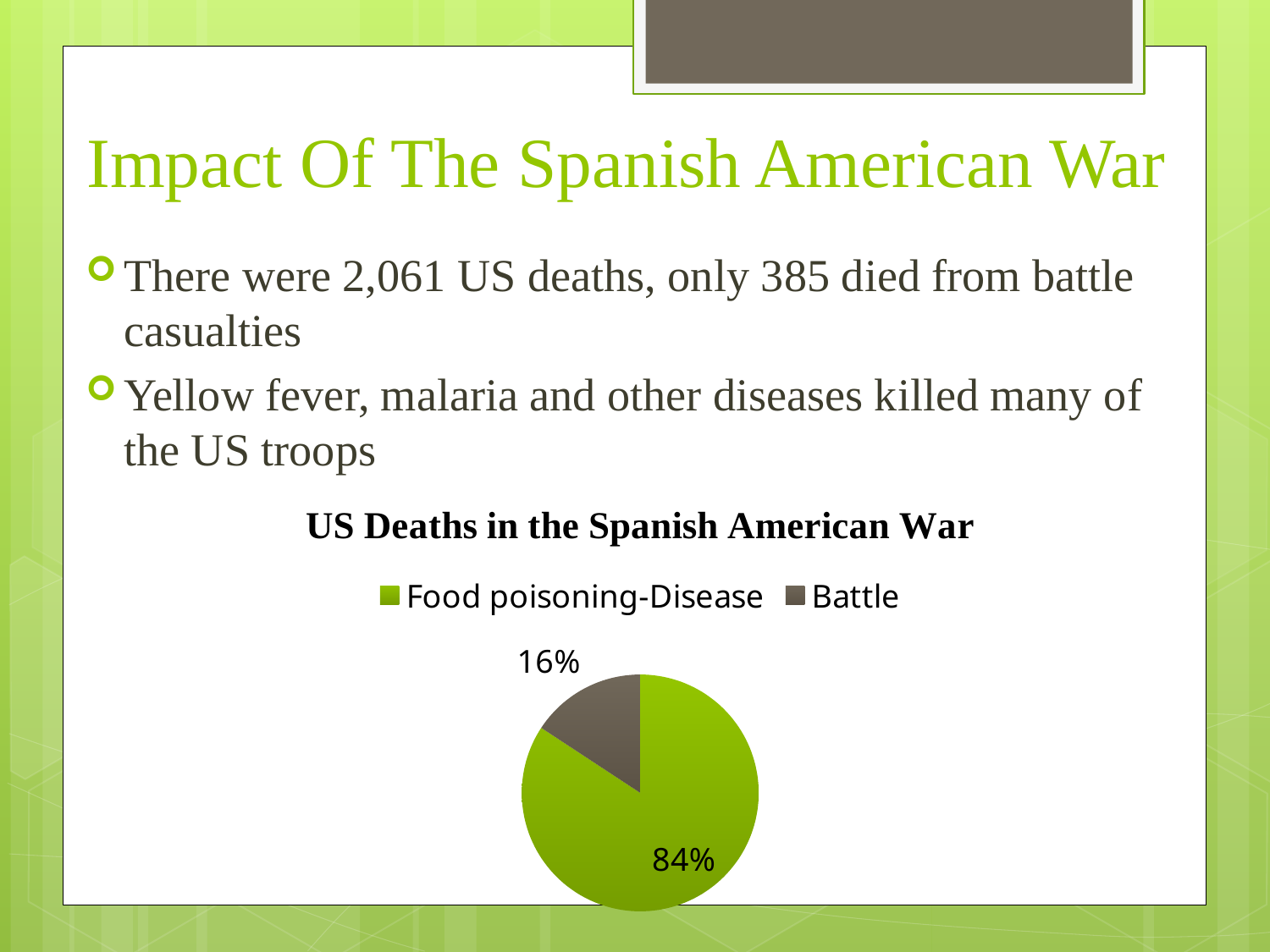
What percentage of US deaths is attributed to Battle? 16% Which category accounts for the smallest share of US deaths? Battle What is the title of the chart? US Deaths in the Spanish American War What is the difference in percentage points between the Food poisoning-Disease share and the Battle share? 68 What type of chart is shown on the slide? pie chart How many entries does the legend list? 2 Which is larger, the share for Battle or the share for Food poisoning-Disease? Food poisoning-Disease What share of the pie does the Battle slice represent? 16% Which category accounts for the largest share of US deaths? Food poisoning-Disease What colour is the Battle slice in the pie chart? grey-brown How many categories does the pie chart show? 2 What percentage of US deaths is attributed to Food poisoning-Disease? 84%